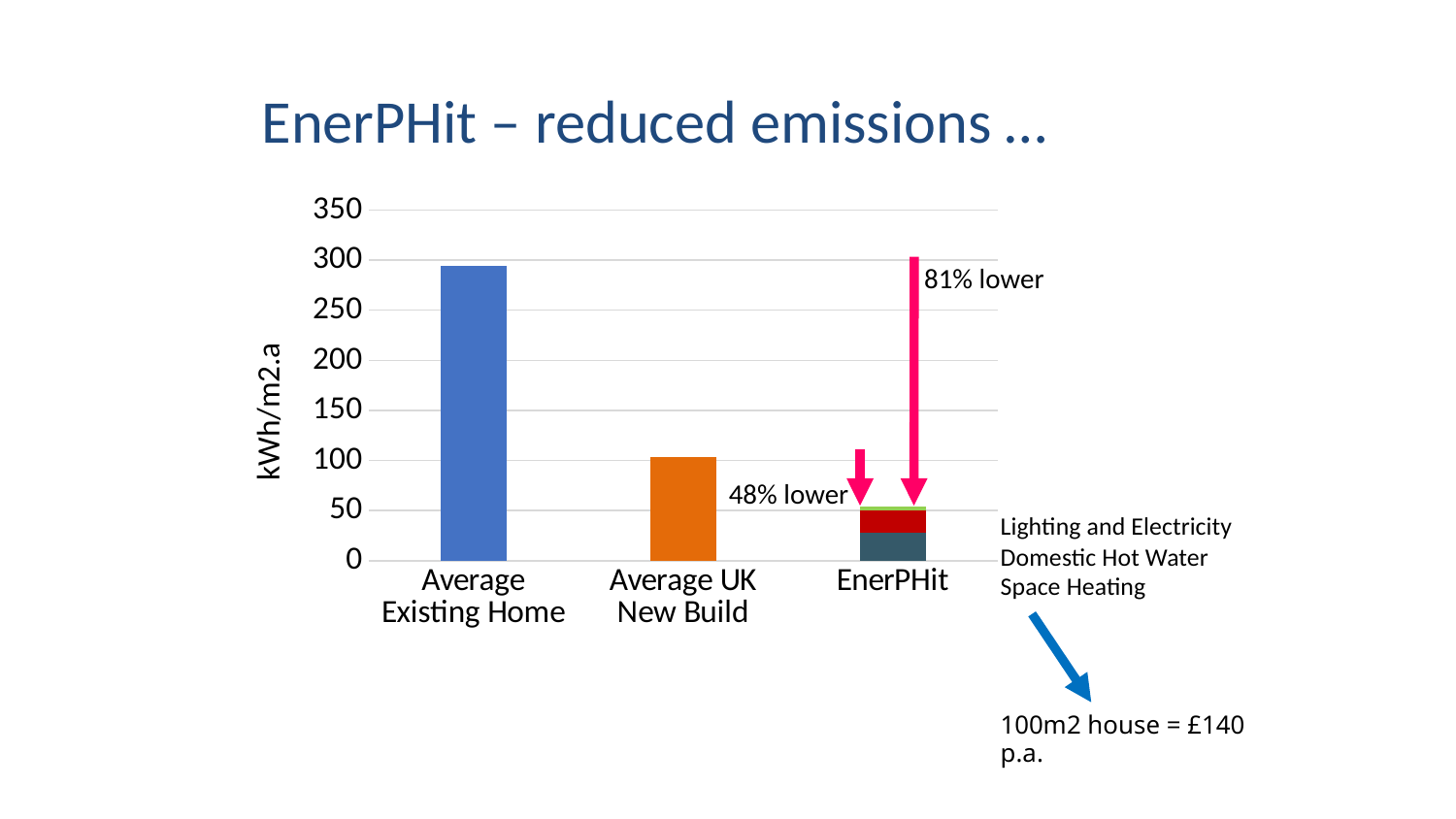
Which is larger, the value for Average UK New Build or the value for EnerPHit? Average UK New Build How many categories are shown on the x axis of the chart? 3 Is the value for Average Existing Home greater or less than 250? greater Which category has the lowest value in the chart? EnerPHit Is the value for Average UK New Build greater or less than 150? less Is the total value for EnerPHit greater or less than 100? less Which category has the highest value in the chart? Average Existing Home According to the annotation on the chart, by what percentage is EnerPHit lower than the Average Existing Home? 81% lower What kind of chart is shown on the slide? bar chart Do the values rise or fall from left to right along the x axis? fall What is the label on the y axis of the chart? kWh/m2.a